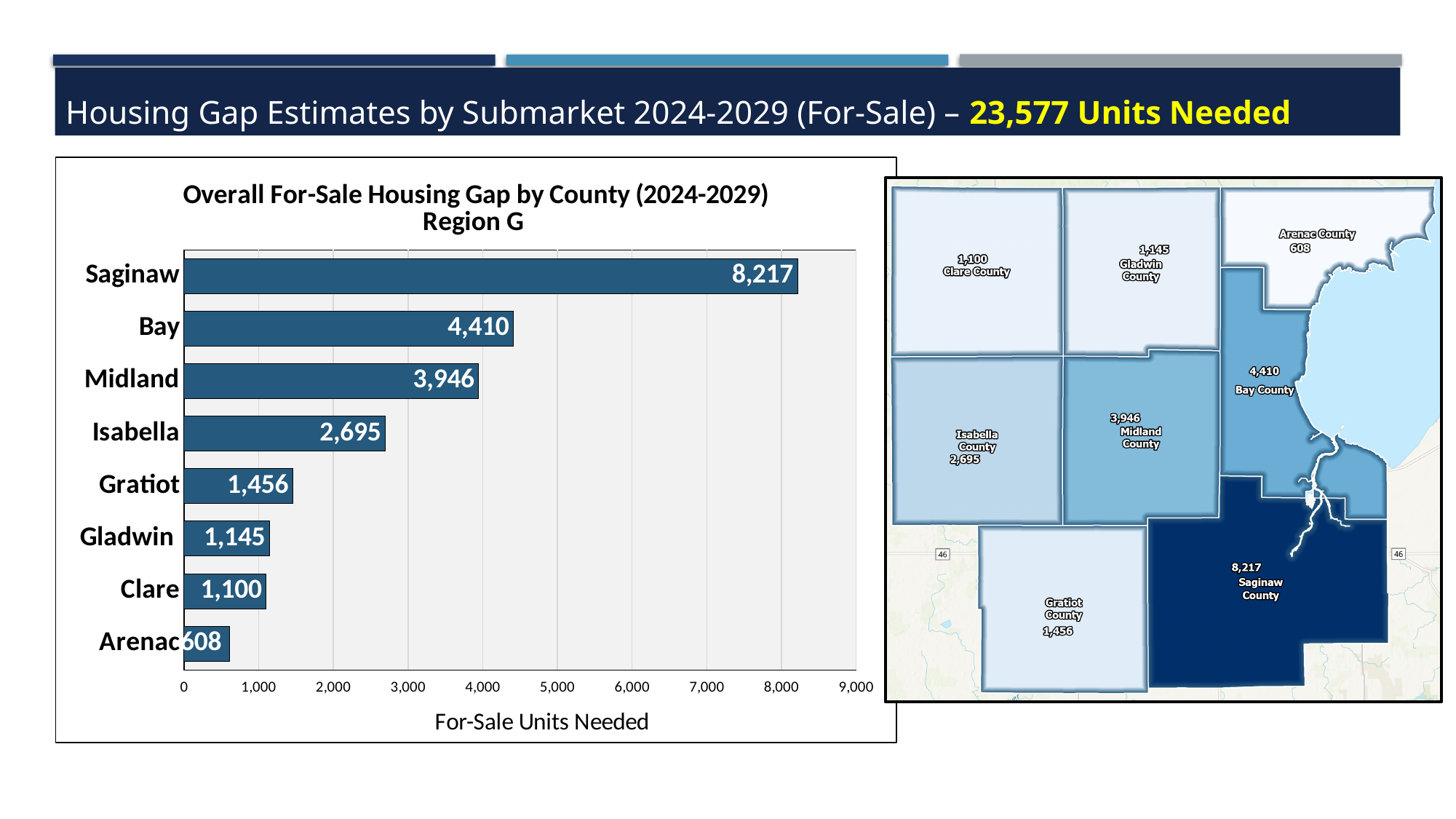
Which has a larger for-sale housing gap, Midland or Isabella? Midland Which county has the lowest for-sale housing gap? Arenac What is the for-sale housing gap value for Isabella? 2,695 What is the for-sale housing gap value for Saginaw? 8,217 Is the value for Bay greater or less than 4,000? greater What is the for-sale housing gap value for Gladwin? 1,145 What kind of chart is used to show the for-sale housing gap by county? bar chart What is the difference between the values for Bay and Midland? 464 What is the label on the horizontal axis of the bar chart? For-Sale Units Needed Which county has the highest for-sale housing gap? Saginaw What is the difference between the values for Gratiot and Clare? 356 How many counties are shown in the bar chart? 8